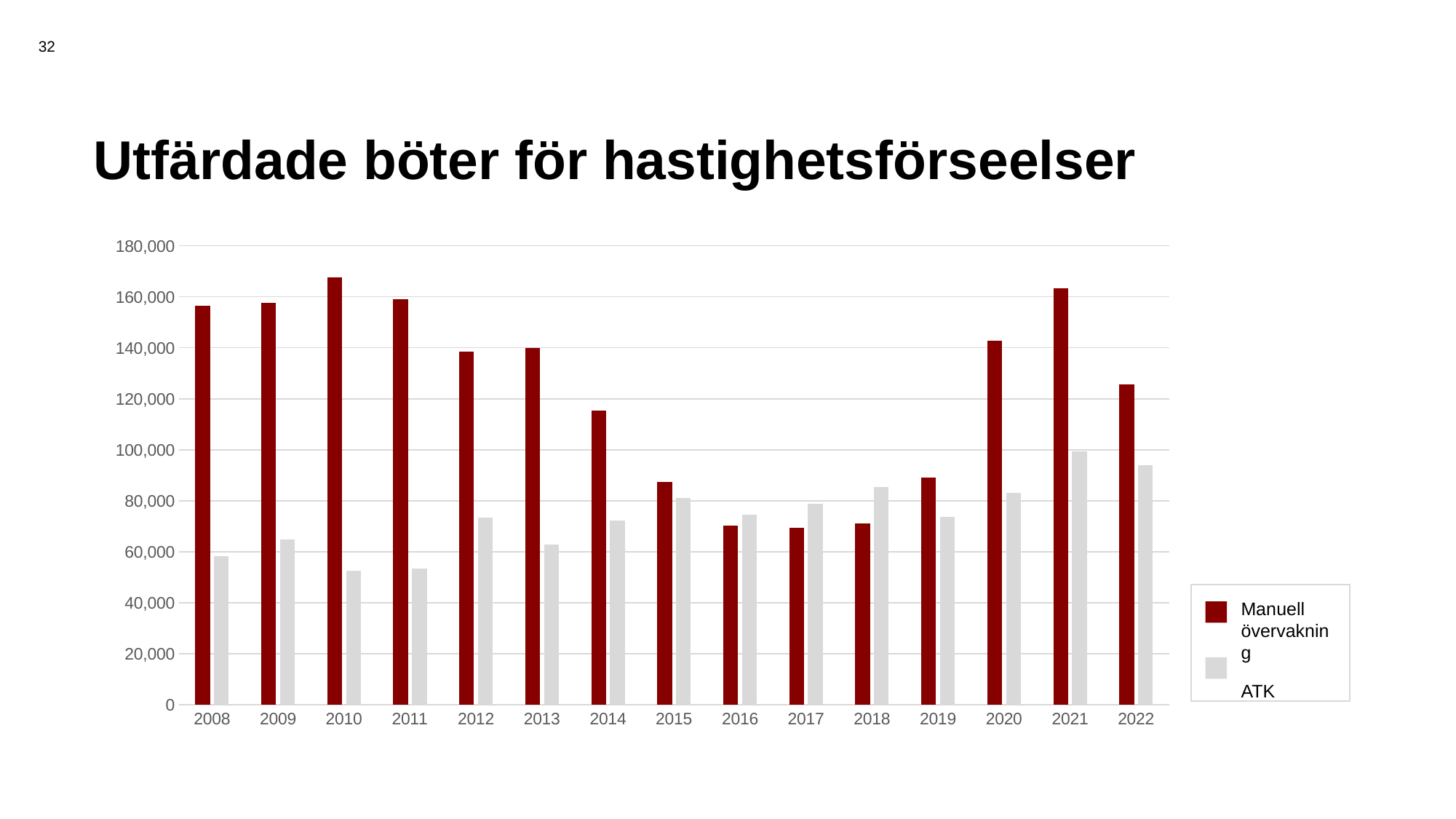
In 2017, which series has the larger value, Manuell övervakning or ATK? ATK How many years are shown on the x axis? 15 How many series does the legend list? 2 Which year has the highest value for Manuell övervakning? 2010 Is the value for ATK in 2008 greater or less than 60,000? less Is the value for Manuell övervakning in 2014 greater or less than 100,000? greater What is the title of the chart? Utfärdade böter för hastighetsförseelser Is the value for Manuell övervakning in 2010 greater or less than 160,000? greater Which year has the highest value for ATK? 2021 Does the value for Manuell övervakning rise or fall overall from 2011 to 2017? fall What kind of chart is shown on the slide? bar chart